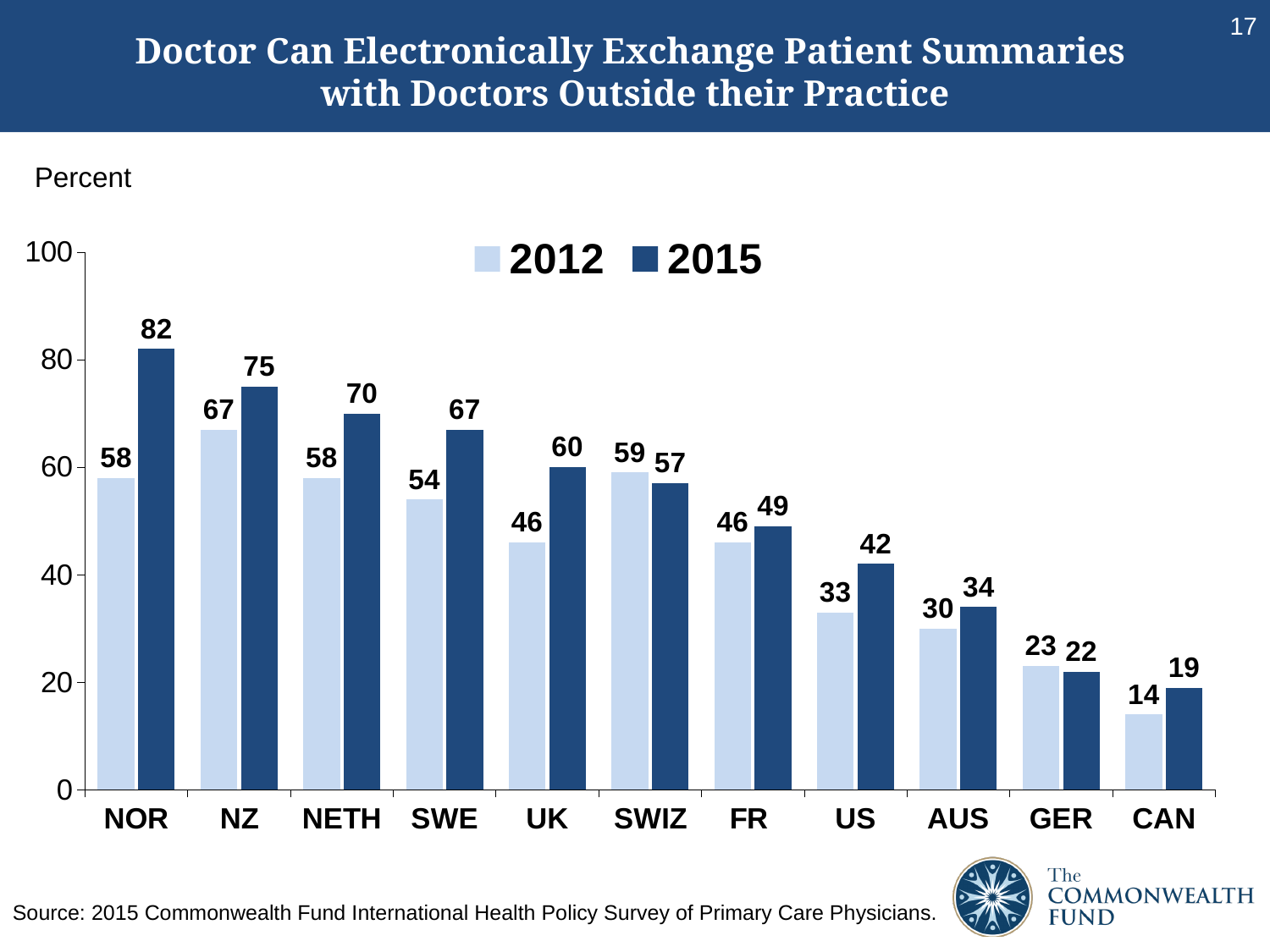
Which country has the lowest 2012 value? CAN Is the 2015 value for UK greater or less than 40? greater What are the two series listed in the legend? 2012 and 2015 Do the 2015 values generally rise or fall from left to right along the x axis? fall Which is larger for SWIZ, the 2012 value or the 2015 value? 2012 What is the difference between the 2015 and 2012 values for NOR? 24 Which country has the highest 2015 value? NOR What is the 2015 value for NOR? 82 How many series does the legend list? 2 How many countries are shown on the x axis? 11 What kind of chart is shown on the slide? bar chart What is the 2012 value for SWE? 54